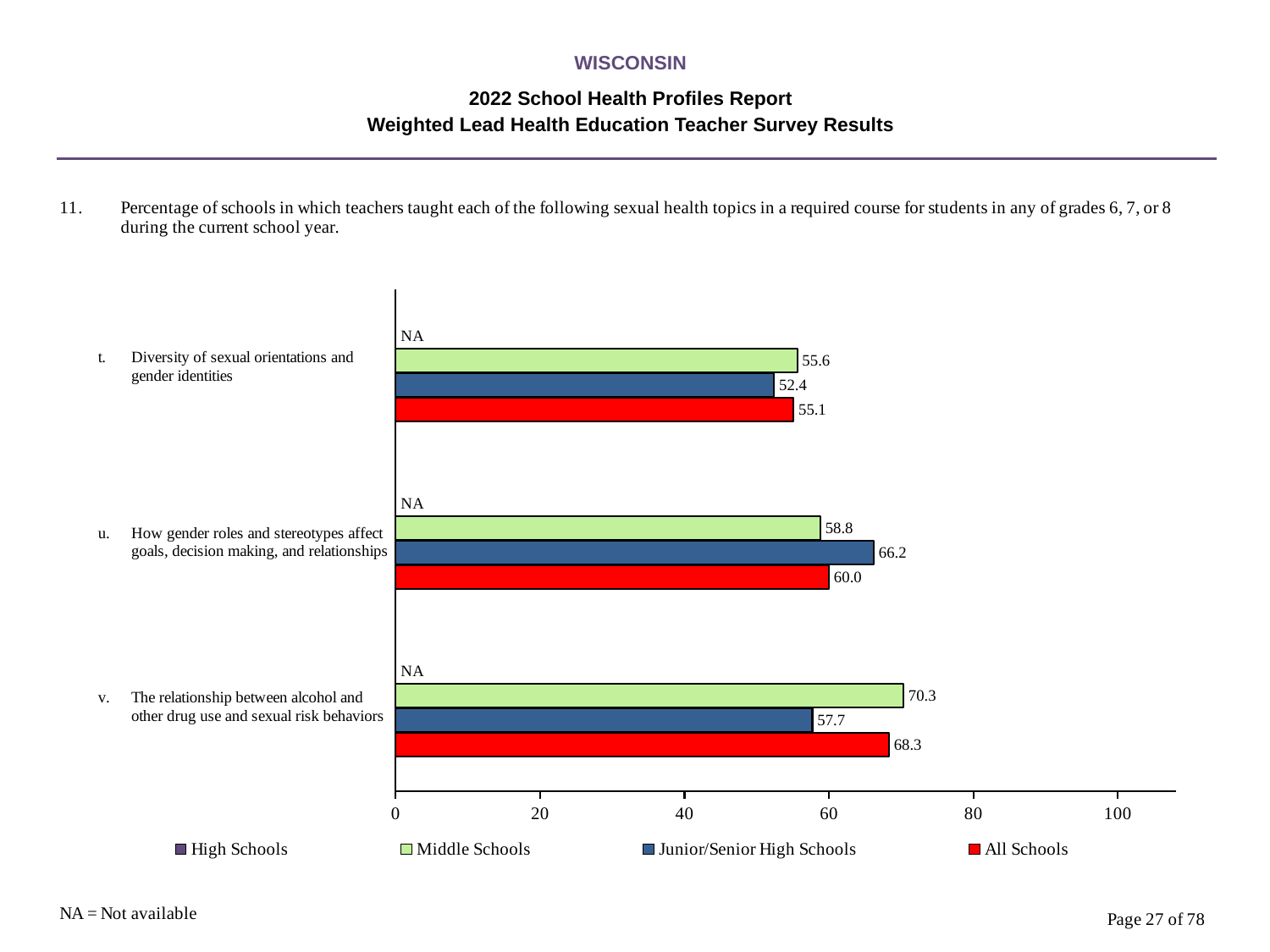
What type of chart is shown on the slide? bar chart For 'How gender roles and stereotypes affect goals, decision making, and relationships', which is larger: the Middle Schools value or the Junior/Senior High Schools value? Junior/Senior High Schools How many topics (categories) are shown on the chart? 3 Is the All Schools value for 'Diversity of sexual orientations and gender identities' greater or less than 60? less What is shown for High Schools for each topic on this chart? NA Which topic has the highest Middle Schools value? The relationship between alcohol and other drug use and sexual risk behaviors How many series does the legend list? 4 Which topic has the lowest Junior/Senior High Schools value? Diversity of sexual orientations and gender identities What is the Middle Schools value for 'Diversity of sexual orientations and gender identities'? 55.6 What is the All Schools value for 'The relationship between alcohol and other drug use and sexual risk behaviors'? 68.3 What is the difference between the Middle Schools and Junior/Senior High Schools values for 'The relationship between alcohol and other drug use and sexual risk behaviors'? 12.6 What is the Junior/Senior High Schools value for 'How gender roles and stereotypes affect goals, decision making, and relationships'? 66.2